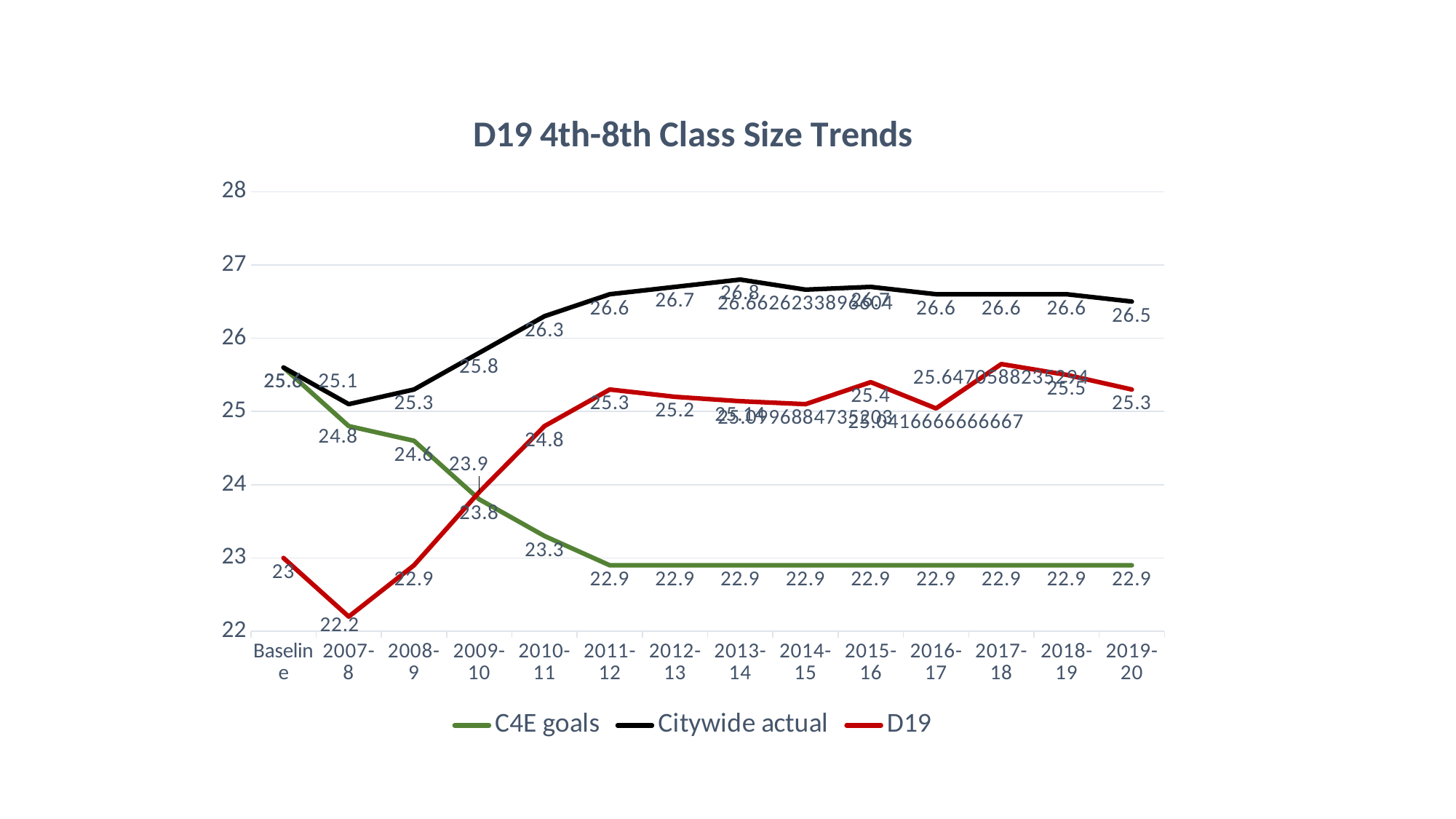
In which year is the D19 value lowest? 2007-8 What is the Citywide actual value for 2019-20? 26.5 What is the difference between the Citywide actual and D19 values for 2019-20? 1.2 Which is larger in 2010-11, the Citywide actual value or the D19 value? Citywide actual Is the Citywide actual value for 2013-14 greater or less than 26? greater How many categories are shown on the x axis? 14 What type of chart is shown on the slide? Line chart How many series does the legend list? 3 What is the D19 value for 2007-8? 22.2 What is the C4E goals value for 2010-11? 23.3 Do the C4E goals values rise or fall from Baseline to 2011-12? Fall What is the title of the chart? D19 4th-8th Class Size Trends